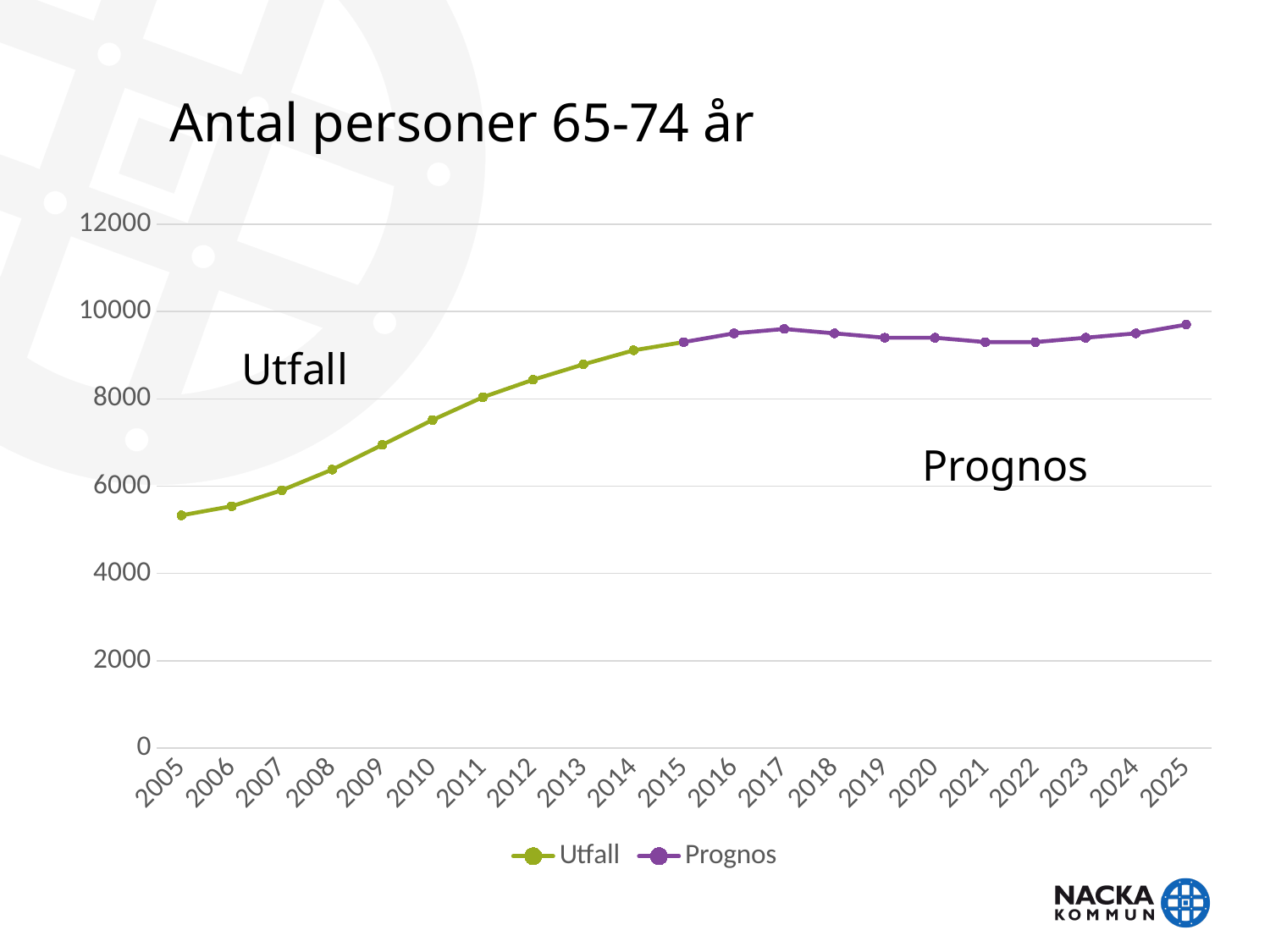
How many series does the legend list? 2 How many years are shown on the x axis? 21 What are the two series named in the legend? Utfall and Prognos What kind of chart is shown on the slide? Line chart Is the Prognos value for 2025 greater or less than 10000? less Is the Utfall value for 2005 greater or less than 6000? less Is the Utfall value for 2015 greater or less than 8000? greater Which year has the lowest value in the Utfall series? 2005 What is the title of the chart? Antal personer 65-74 år Does the Utfall series rise or fall from 2005 to 2015? Rise Which is larger, the Utfall value for 2008 or for 2012? 2012